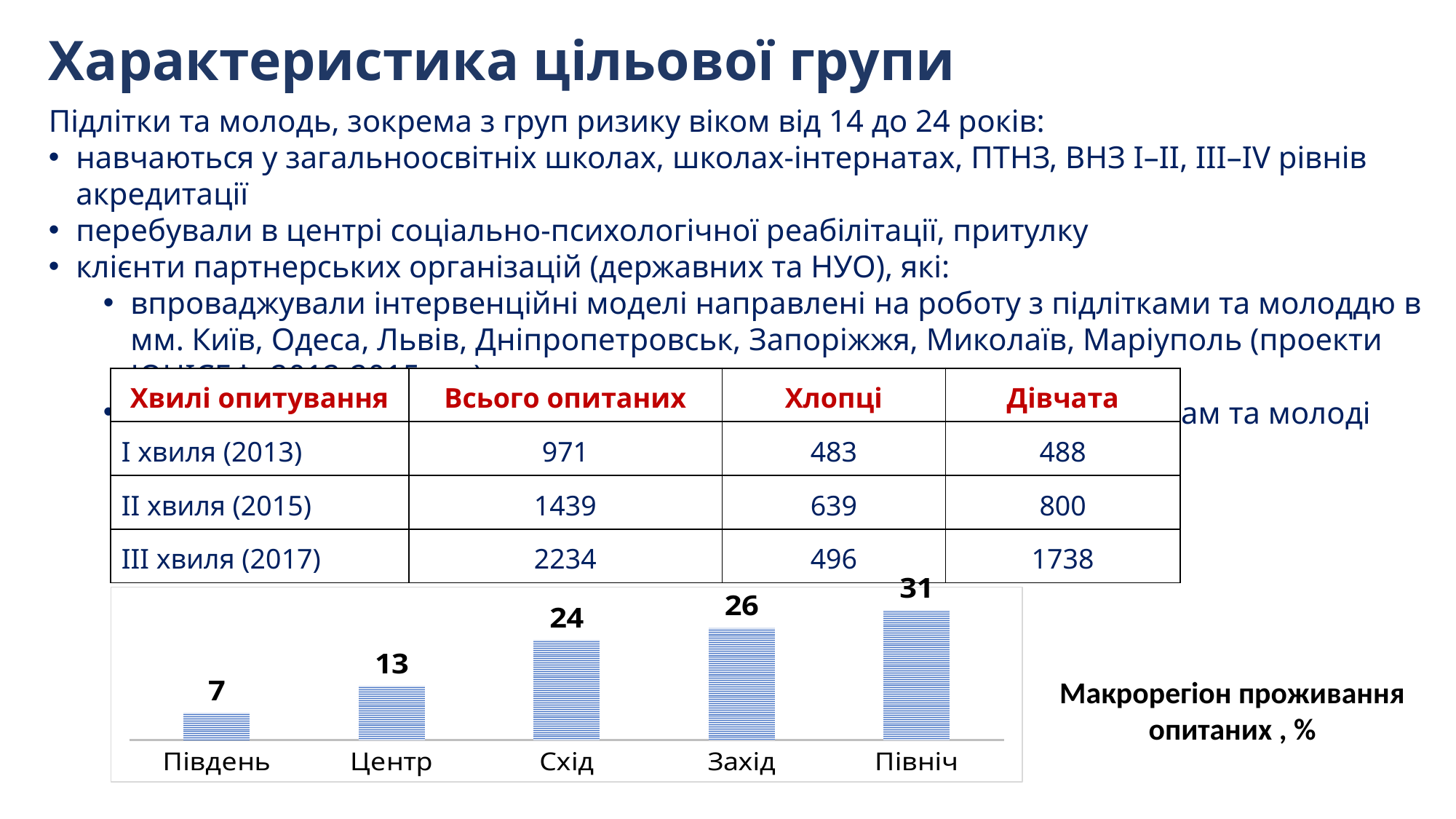
Which macroregion has the lowest value in the chart? Південь Which is larger, the value for Центр or the value for Схід? Схід How many macroregions are shown in the chart? 5 What is the difference between the values for Захід and Схід? 2 What kind of chart is shown on the slide? Bar chart What is the value for Північ in the chart? 31 Which macroregion has the highest value in the chart? Північ Do the values rise or fall from Південь to Північ along the x axis? Rise What is the value for Південь in the chart? 7 What is the value for Центр in the chart? 13 What is the difference between the values for Північ and Південь? 24 What is the value for Схід in the chart? 24